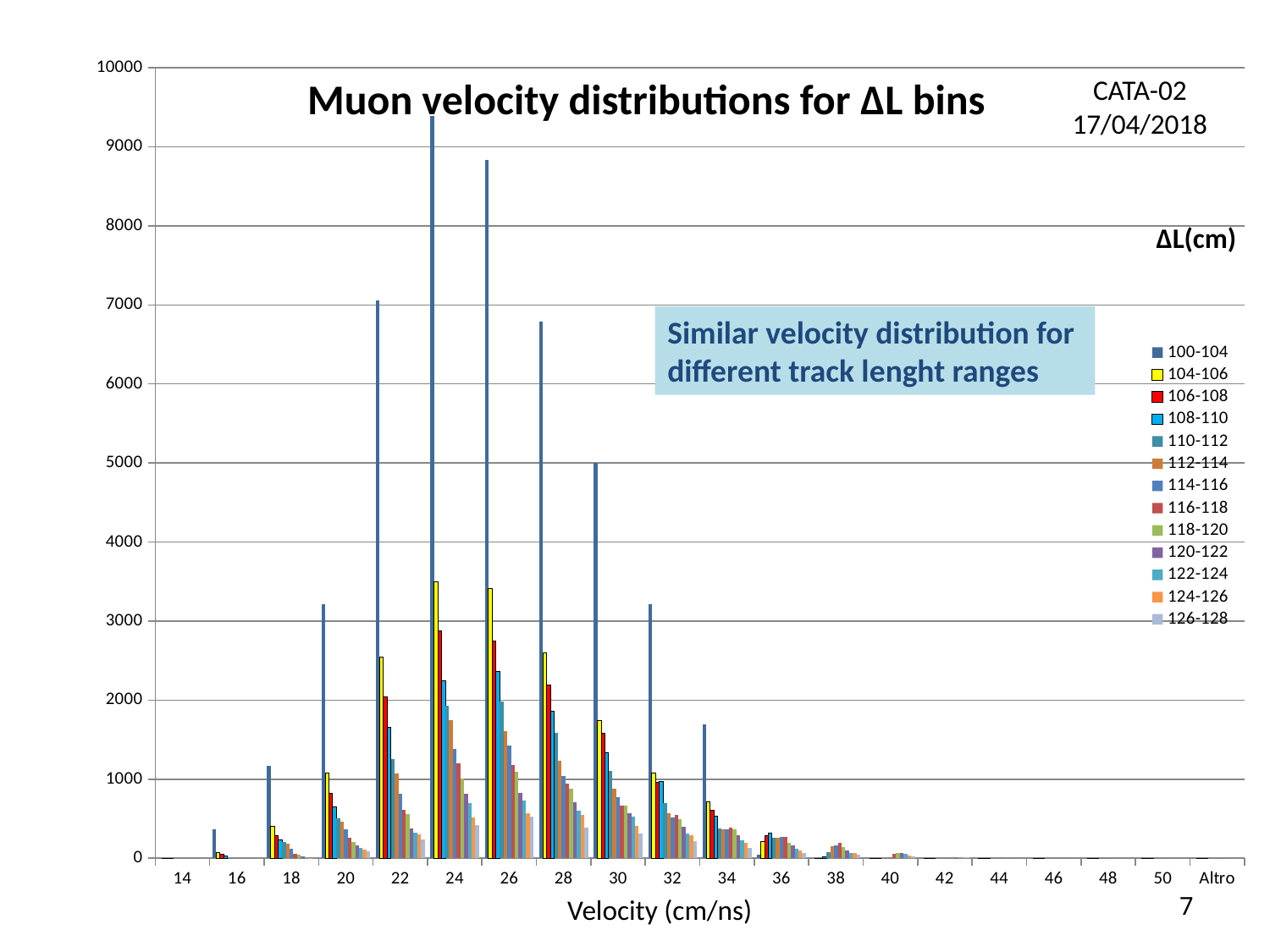
Which is larger for the 100-104 series: the value at velocity 24 or at velocity 26? velocity 24 What is the label of the x axis? Velocity (cm/ns) What kind of chart is shown on the slide? bar chart Is the value of the 100-104 series at velocity 28 greater or less than 7000? less Is the value of the 100-104 series at velocity 24 greater or less than 9000? greater How many series does the legend list? 13 Which is larger at velocity 24: the 100-104 series or the 104-106 series? 100-104 Is the value of the 104-106 series at velocity 24 greater or less than 3000? greater At which velocity does the 100-104 series reach its highest value? 24 What is the title of the chart? Muon velocity distributions for ΔL bins Do the values of the 100-104 series rise or fall from velocity 26 to velocity 36? fall